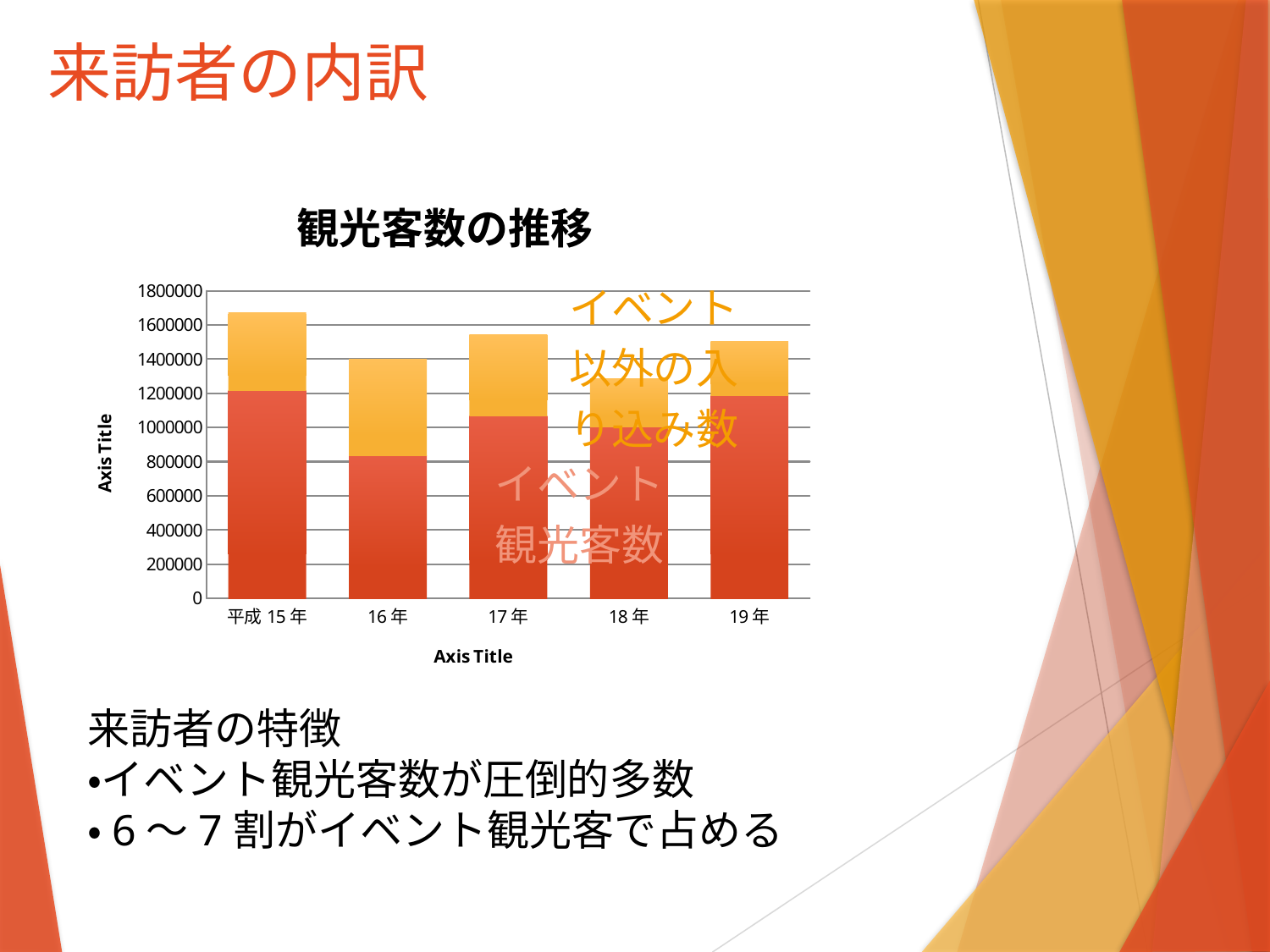
Which series is shown in red at the bottom of each stacked bar? イベント観光客数 Which year has the tallest stacked bar (highest total)? 平成15年 Is the value for イベント観光客数 in 16年 greater or less than 1000000? less What is the title of the chart? 観光客数の推移 Is the total stacked value for 平成15年 greater or less than 1600000? greater Which year has the lowest value for イベント観光客数? 16年 Which year has the shortest stacked bar (lowest total)? 18年 Is the value for イベント観光客数 in 19年 greater or less than 1000000? greater What kind of chart is shown on the slide? Stacked bar chart How many years (categories) are shown on the x axis of the chart? 5 Which is larger, the イベント観光客数 value for 平成15年 or for 16年? 平成15年